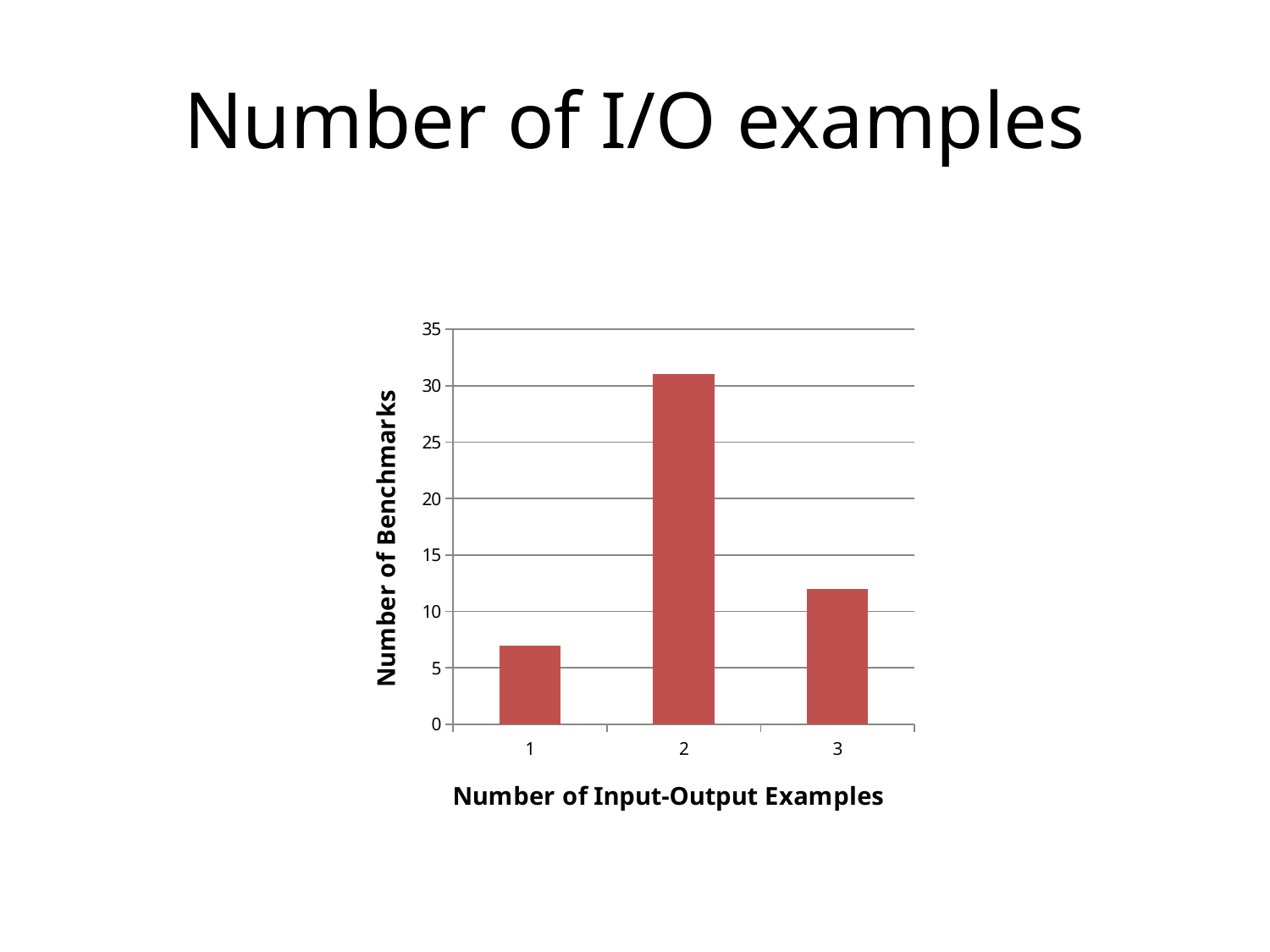
Which number of input-output examples has the highest number of benchmarks? 2 What is the label of the horizontal axis? Number of Input-Output Examples How many bars are plotted in the chart? 3 What kind of chart is shown on the slide? bar chart What is the label of the vertical axis? Number of Benchmarks Is the number of benchmarks for 3 input-output examples greater or less than 15? less Is the number of benchmarks for 2 input-output examples greater or less than 25? greater Is the number of benchmarks for 1 input-output example greater or less than 10? less Which number of input-output examples has the lowest number of benchmarks? 1 Which has more benchmarks: 1 input-output example or 3 input-output examples? 3